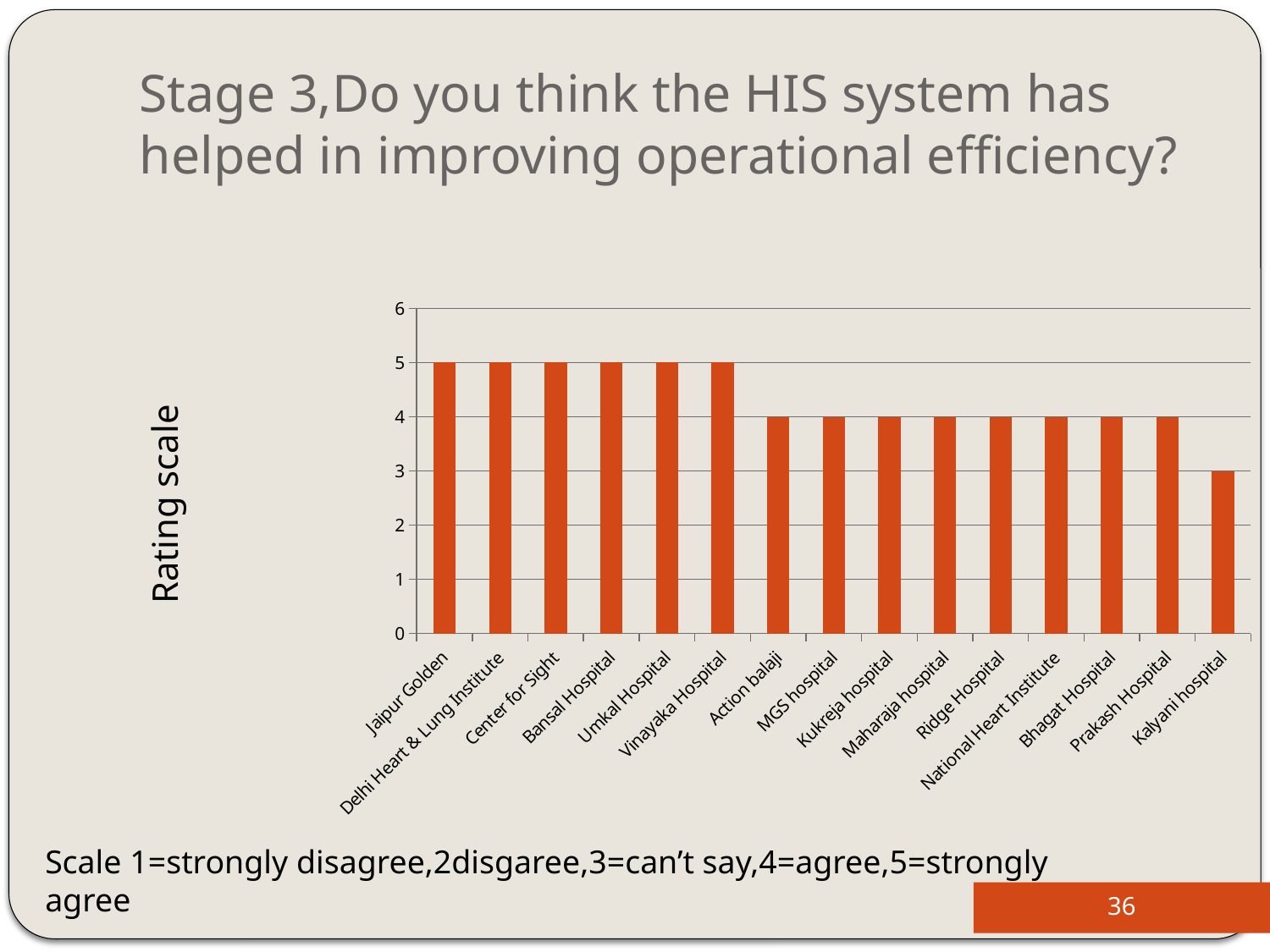
What is the rating for Kalyani hospital? 3 How many hospitals are shown on the x axis of the chart? 15 What is the rating for Jaipur Golden? 5 What is the label on the vertical axis of the chart? Rating scale What is the difference between the rating for Jaipur Golden and the rating for Kalyani hospital? 2 Is the value for Kalyani hospital greater or less than 4? less What is the rating for Vinayaka Hospital? 5 Which has a higher rating, Bansal Hospital or MGS hospital? Bansal Hospital Which hospital has the lowest rating? Kalyani hospital Do the ratings rise or fall moving from left to right along the x axis? fall What is the rating for Action balaji? 4 What kind of chart is shown on the slide? bar chart